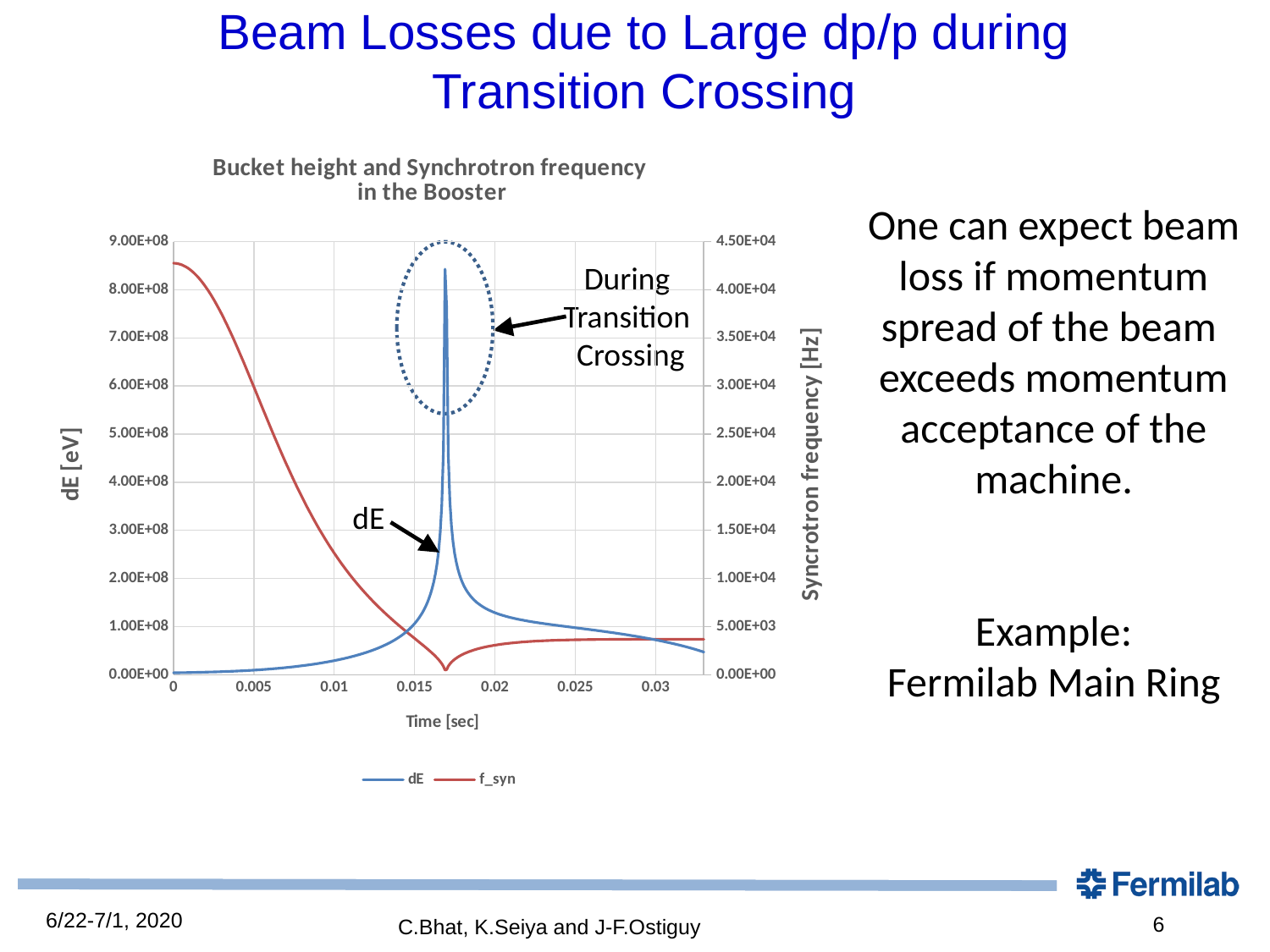
Which series is drawn in red in the chart? f_syn What is the title of the chart? Bucket height and Synchrotron frequency in the Booster Is the value of f_syn at time 0.03 greater or less than 1.00E+04? less Does dE rise or fall as time goes from 0.02 to 0.03 sec? fall Does dE rise or fall as time goes from 0.005 to 0.015 sec? rise What kind of chart is shown on the slide? line chart Does f_syn rise or fall as time goes from 0 to 0.015 sec? fall Is the value of f_syn at time 0 greater or less than 4.00E+04? greater How many series does the chart legend list? 2 Is the value of dE at time 0.005 greater or less than 1.00E+08? less